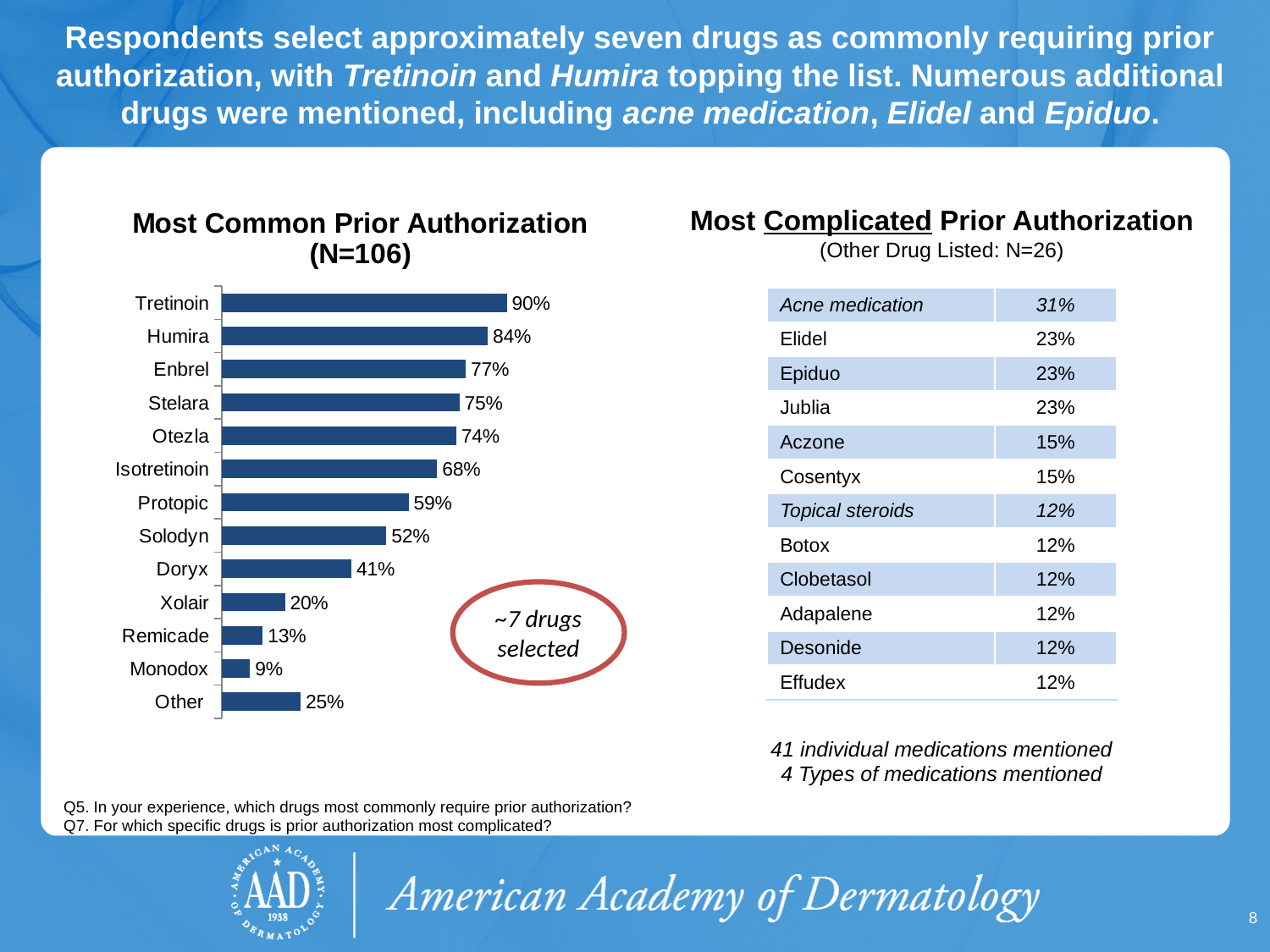
In the 'Most Common Prior Authorization (N=106)' chart, which has a larger value, Protopic or Solodyn? Protopic What text appears in the red oval callout on the 'Most Common Prior Authorization (N=106)' chart? ~7 drugs selected What kind of chart is the 'Most Common Prior Authorization (N=106)' chart? Bar chart In the 'Most Common Prior Authorization (N=106)' chart, what is the difference between the values for Humira and Enbrel? 7% In the 'Most Common Prior Authorization (N=106)' chart, what is the value for Isotretinoin? 68% In the 'Most Common Prior Authorization (N=106)' chart, which drug has the highest value? Tretinoin In the 'Most Common Prior Authorization (N=106)' chart, how many bars are plotted? 13 In the 'Most Common Prior Authorization (N=106)' chart, what is the value for Doryx? 41% In the 'Most Common Prior Authorization (N=106)' chart, what is the value for Tretinoin? 90% In the 'Most Common Prior Authorization (N=106)' chart, which drug has the lowest value? Monodox In the 'Most Common Prior Authorization (N=106)' chart, what is the difference between the values for Xolair and Remicade? 7% In the 'Most Common Prior Authorization (N=106)' chart, what is the value for Other? 25%